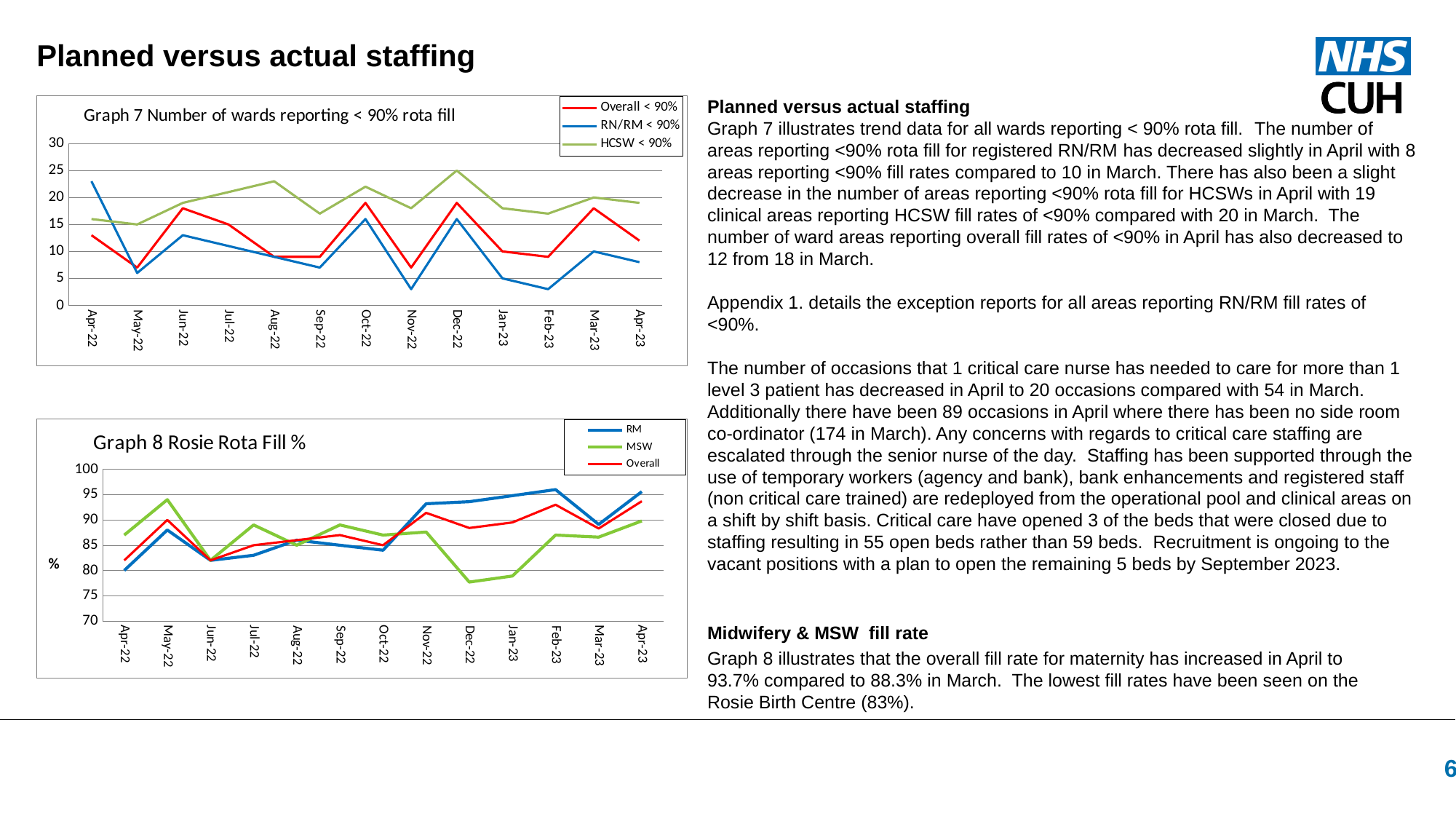
In Graph 7 Number of wards reporting < 90% rota fill, in which month does the RN/RM < 90% series reach its lowest value? Nov-22 and Feb-23 In Graph 7 Number of wards reporting < 90% rota fill, is the RN/RM < 90% value for Nov-22 greater or less than 5? less In Graph 8 Rosie Rota Fill %, is the MSW value for Dec-22 greater or less than 80? less How many series does the legend of Graph 8 Rosie Rota Fill % list? 3 In Graph 8 Rosie Rota Fill %, which series has the larger value in Dec-22, RM or MSW? RM How many series does the legend of Graph 7 Number of wards reporting < 90% rota fill list? 3 In Graph 8 Rosie Rota Fill %, in which month does the MSW series reach its lowest value? Dec-22 How many months are plotted along the x axis of Graph 7 Number of wards reporting < 90% rota fill? 13 In Graph 7 Number of wards reporting < 90% rota fill, in which month does the HCSW < 90% series reach its highest value? Dec-22 What type of chart is Graph 7 Number of wards reporting < 90% rota fill? line chart In Graph 7 Number of wards reporting < 90% rota fill, which series has the larger value in Dec-22, HCSW < 90% or RN/RM < 90%? HCSW < 90% In Graph 7 Number of wards reporting < 90% rota fill, is the HCSW < 90% value for Dec-22 greater or less than 20? greater